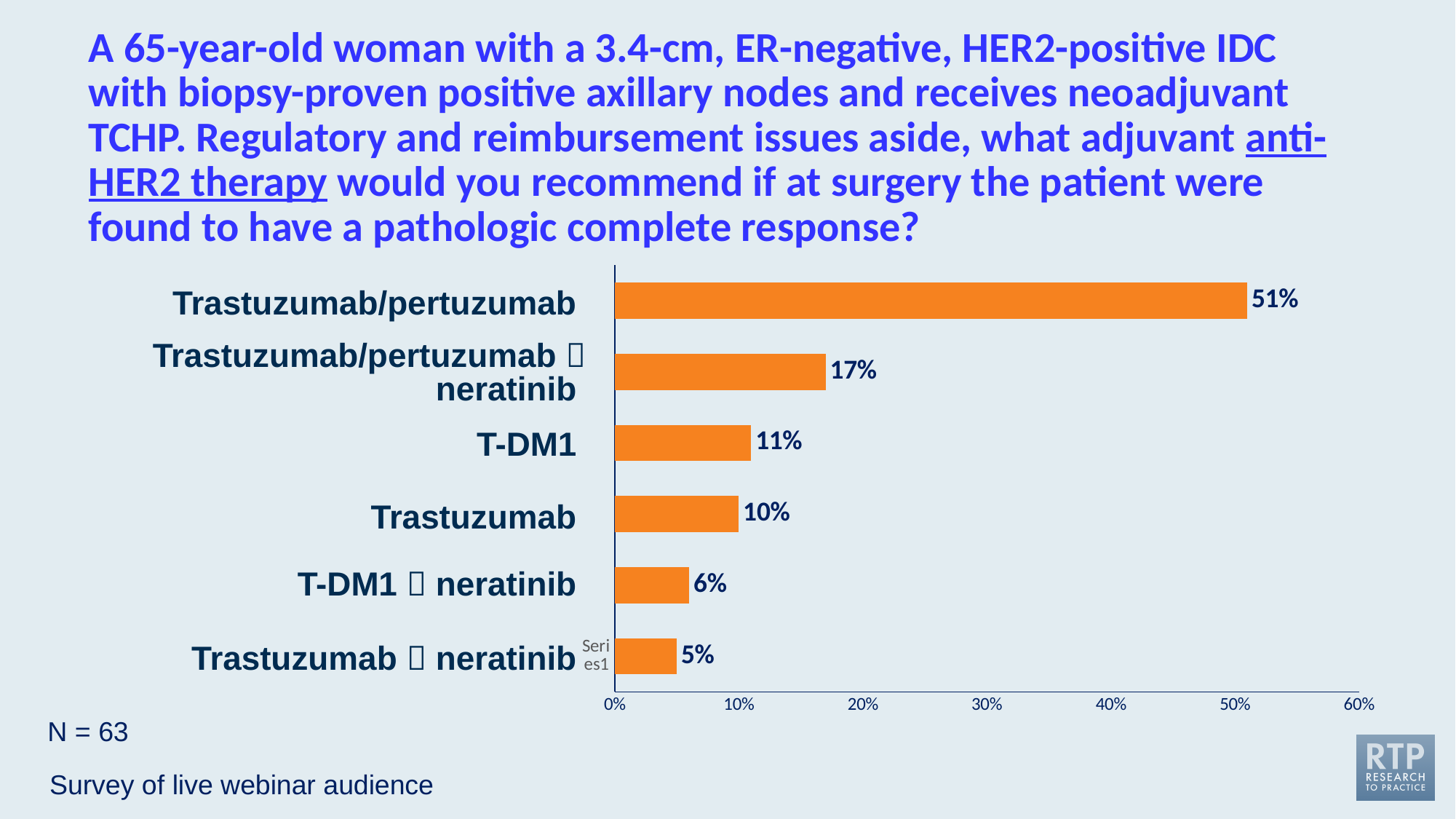
What is the maximum value shown on the x axis of the chart? 60% Which has a larger value, T-DM1 or Trastuzumab? T-DM1 Is the value for Trastuzumab/pertuzumab greater or less than 50%? greater How many answer options (bars) are shown on the chart? 6 What percentage of respondents chose Trastuzumab alone? 10% What type of chart is shown on the slide? Bar chart What percentage of respondents chose T-DM1? 11% What is the value shown for the bottom bar of the chart? 5% Which option received the highest percentage of responses? Trastuzumab/pertuzumab What is the lowest value shown on the chart? 5% What is the difference between the values for Trastuzumab/pertuzumab and T-DM1? 40% What percentage of respondents chose Trastuzumab/pertuzumab? 51%